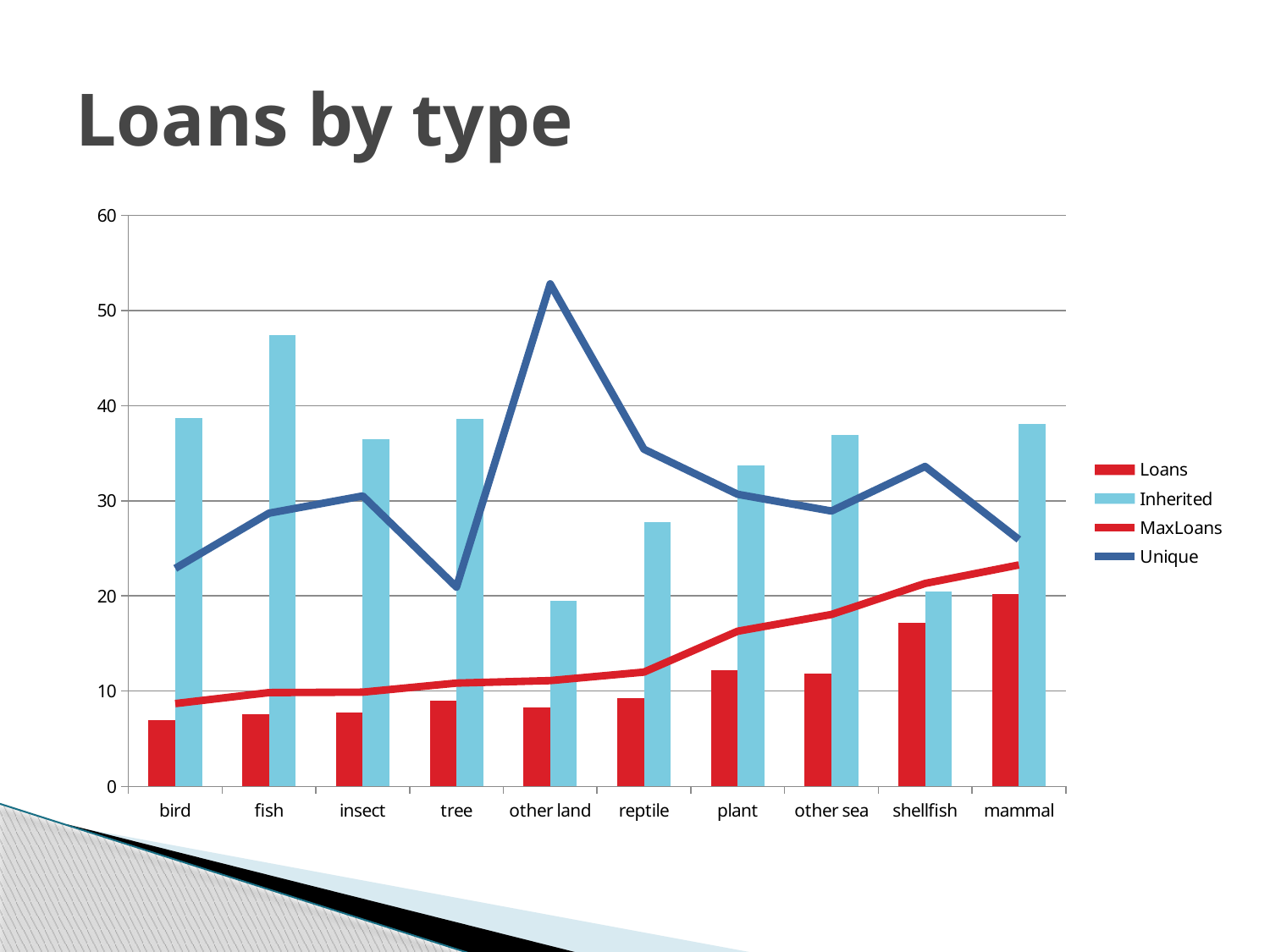
Is the Loans value for shellfish greater or less than 20? less What kind of chart is shown on the slide? A combined bar and line chart How many series does the legend list? 4 At which category does the Unique line reach its lowest point? tree Which is larger, the Loans value for mammal or the Loans value for shellfish? mammal How many categories are shown on the x axis? 10 Which category has the highest Loans bar? mammal Does the MaxLoans line rise or fall from bird to mammal along the x axis? rise At which category does the Unique line reach its highest point? other land Which category has the highest Inherited bar? fish Is the Unique value for other land greater or less than 50? greater Is the Inherited value for fish greater or less than 40? greater